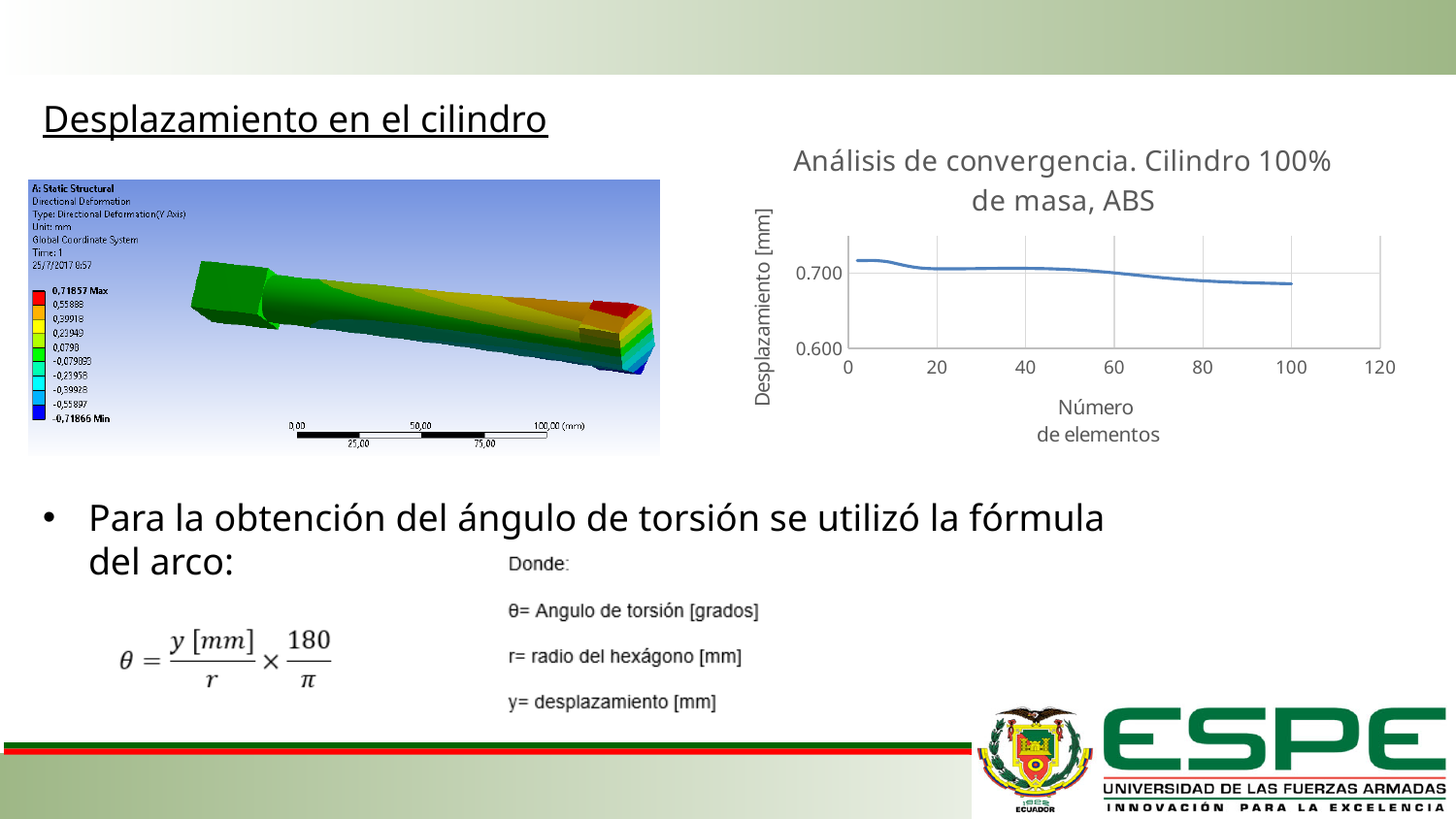
What is the lowest tick value shown on the y axis of the chart? 0.600 What is the highest tick value shown on the x axis of the chart? 120 Is the displacement value at 100 elements greater or less than 0.700? less What kind of chart is shown on the slide? line chart Is the displacement value at 60 elements greater or less than 0.600? greater What is the title of the chart? Análisis de convergencia. Cilindro 100% de masa, ABS What is the label of the y axis of the chart? Desplazamiento [mm] Is the displacement value at the start of the line (near 0 elements) greater or less than 0.700? greater Does the displacement rise or fall as the number of elements increases along the x axis? fall Which end of the line has the higher displacement, the left end (few elements) or the right end (100 elements)? left end